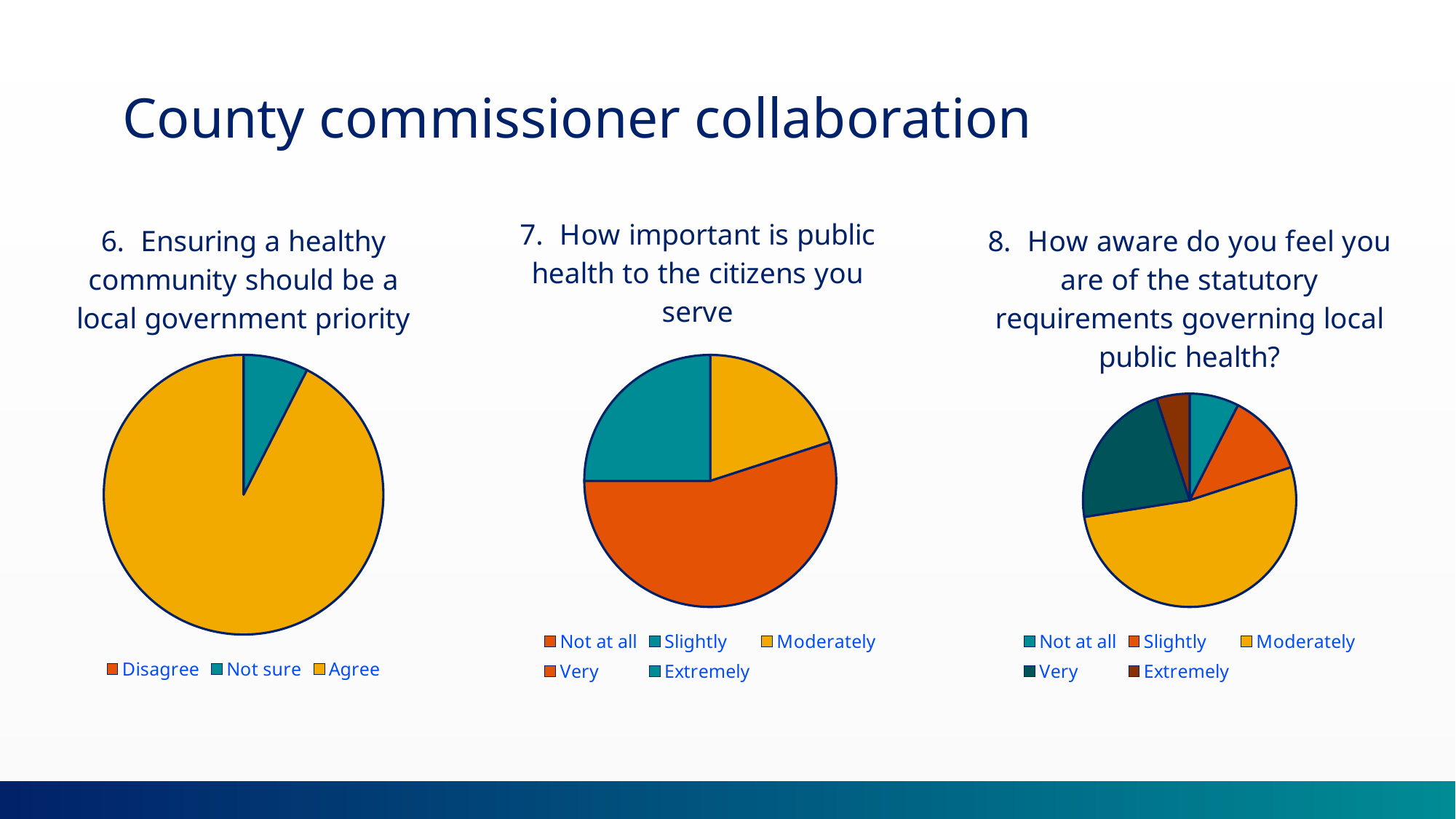
What kind of chart is used for question 6, "Ensuring a healthy community should be a local government priority"? Pie chart In the chart for question 7 (how important is public health to the citizens you serve), which is larger: Very or Extremely? Very In the chart for question 6 (healthy community as a local government priority), which response has the largest slice? Agree How many slices are visible in the pie chart for question 7 (how important is public health)? 3 In the chart for question 8 (awareness of statutory requirements), which is larger: Very or Slightly? Very In the chart for question 7 (how important is public health to the citizens you serve), which response has the largest slice? Very How many entries does the legend list for the question 6 chart (healthy community as a local government priority)? 3 How many slices are visible in the pie chart for question 8 (awareness of statutory requirements)? 5 How many entries does the legend list for the question 7 chart (how important is public health)? 5 What is the title of the slide containing the three pie charts? County commissioner collaboration In the chart for question 6 (healthy community as a local government priority), which is larger: Agree or Not sure? Agree In the chart for question 8 (awareness of statutory requirements governing local public health), which response has the largest slice? Moderately